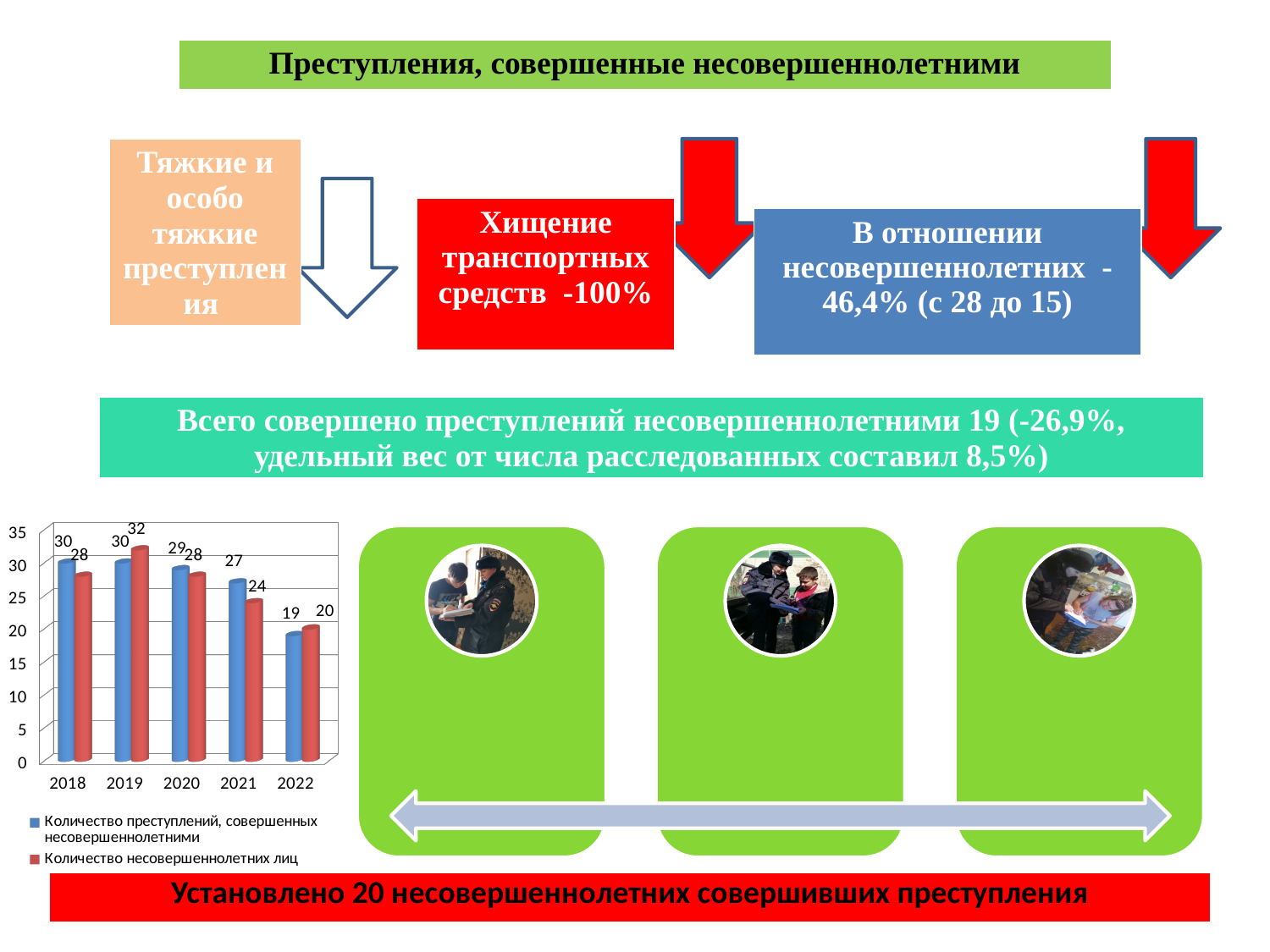
In which year is "Количество несовершеннолетних лиц" the highest? 2019 How many years are shown on the x axis of the chart? 5 Does "Количество преступлений, совершенных несовершеннолетними" rise or fall from 2018 to 2022? fall What type of chart is shown on the slide? bar chart What is the difference between "Количество преступлений, совершенных несовершеннолетними" in 2018 and in 2022? 11 What is the value of "Количество несовершеннолетних лиц" for 2019? 32 What is the value of "Количество несовершеннолетних лиц" for 2021? 24 Which is larger in 2021: "Количество преступлений, совершенных несовершеннолетними" or "Количество несовершеннолетних лиц"? Количество преступлений, совершенных несовершеннолетними In which year is "Количество преступлений, совершенных несовершеннолетними" the lowest? 2022 How many series does the chart legend list? 2 What colour are the bars for "Количество несовершеннолетних лиц"? red What is the value of "Количество преступлений, совершенных несовершеннолетними" for 2022? 19